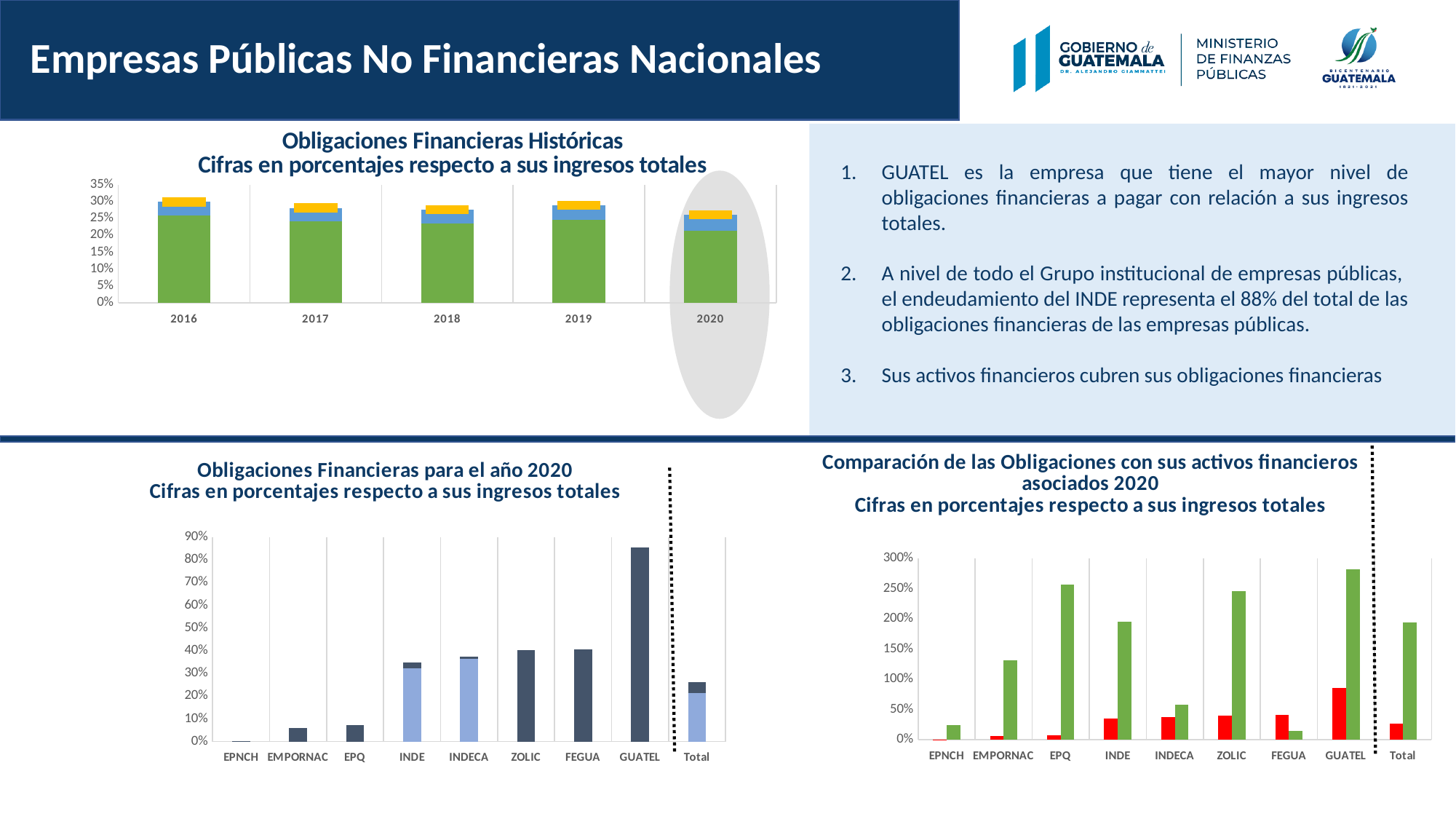
In the 'Comparación de las Obligaciones con sus activos financieros asociados 2020' chart, which category has the tallest green bar? GUATEL In the 'Obligaciones Financieras para el año 2020' chart, how many categories are shown on the x axis? 9 In the 'Obligaciones Financieras Históricas' chart, which year has the tallest stacked bar? 2016 In the 'Obligaciones Financieras para el año 2020' chart, is the value for Total greater or less than 30%? less In the 'Obligaciones Financieras para el año 2020' chart, which category has the lowest value? EPNCH In the 'Obligaciones Financieras Históricas' chart, how many years are shown on the x axis? 5 In the 'Obligaciones Financieras para el año 2020' chart, is the value for GUATEL greater or less than 80%? greater In the 'Obligaciones Financieras para el año 2020' chart, which category has the highest value? GUATEL In the 'Obligaciones Financieras Históricas' chart, is the total for 2020 greater or less than 30%? less What kind of chart is the 'Obligaciones Financieras Históricas' chart? Stacked bar chart In the 'Obligaciones Financieras Históricas' chart, which year has the shortest stacked bar? 2020